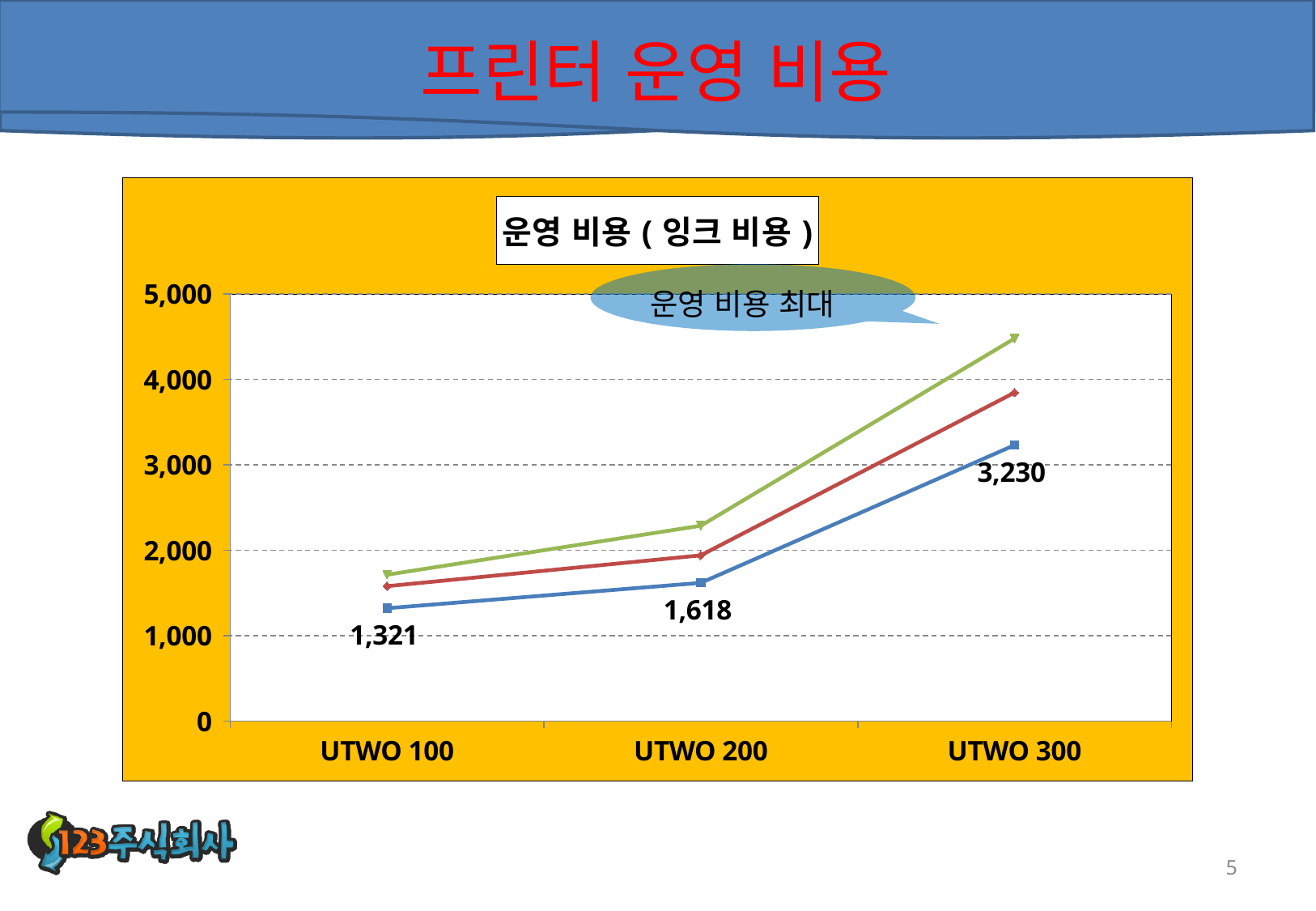
Do the values of the lines rise or fall from UTWO 100 to UTWO 300? rise Is the value of the green line at UTWO 300 greater or less than 4,000? greater How many printer models (categories) are shown on the x axis of the chart? 3 What is the labelled value of the blue line at UTWO 300? 3,230 What is the difference between the blue line's values at UTWO 200 and UTWO 100? 297 What kind of chart is shown on the slide? line chart How many lines are plotted in the chart? 3 What is the title of the chart? 운영 비용 ( 잉크 비용 ) What is the labelled value of the blue line at UTWO 100? 1,321 What is the difference between the blue line's values at UTWO 300 and UTWO 100? 1,909 At which printer model does the blue line reach its highest value? UTWO 300 What is the labelled value of the blue line at UTWO 200? 1,618